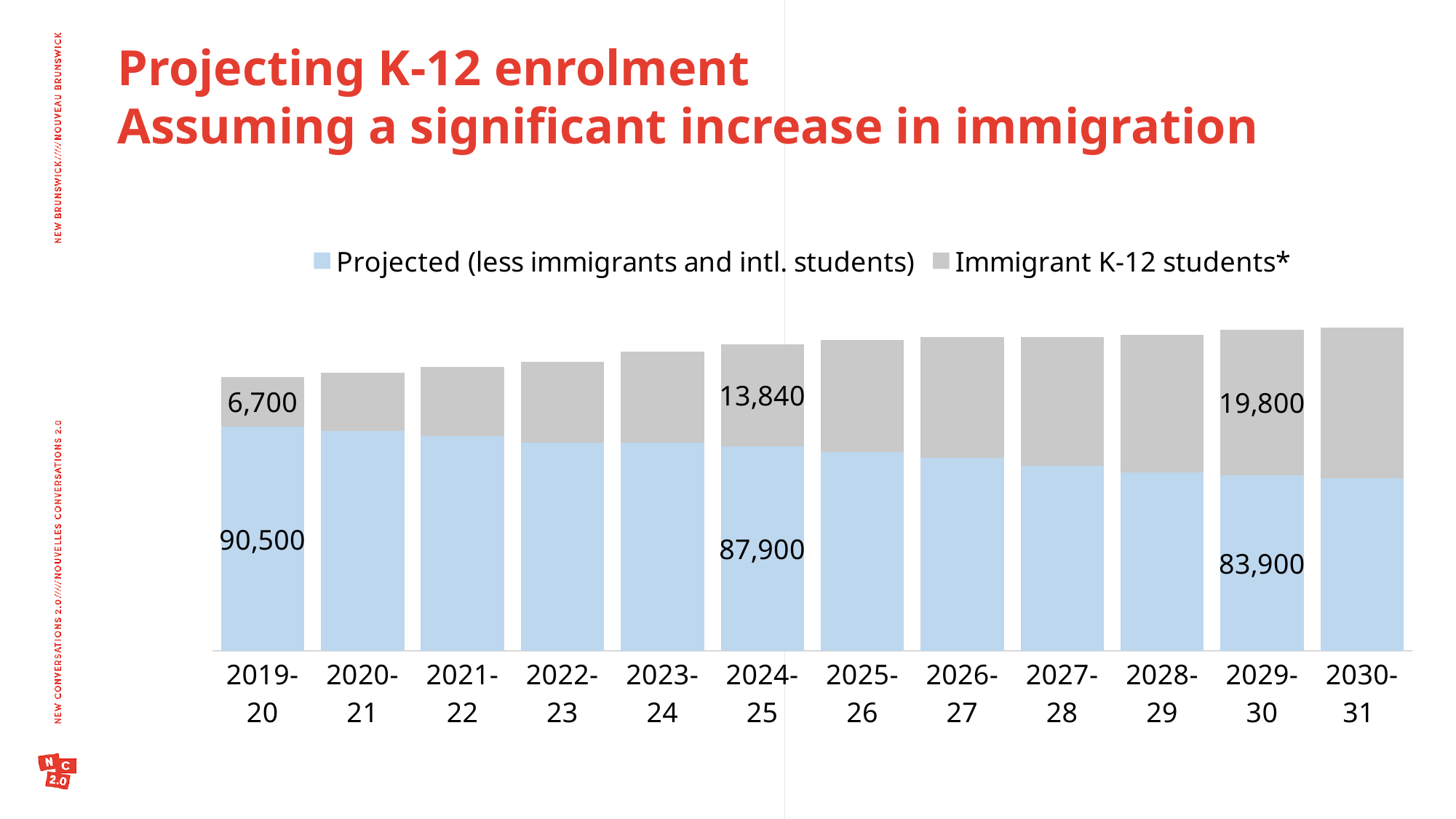
What is the value of the Immigrant K-12 students* series for 2029-30? 19,800 What is the total of the stacked bar for 2019-20? 97,200 What is the value of the Projected (less immigrants and intl. students) series for 2019-20? 90,500 Which is larger: the Immigrant K-12 students* value for 2024-25 or for 2019-20? 2024-25 What is the value of the Projected (less immigrants and intl. students) series for 2029-30? 83,900 What is the difference between the Immigrant K-12 students* values for 2029-30 and 2019-20? 13,100 What is the value of the Immigrant K-12 students* series for 2024-25? 13,840 What is the total of the stacked bar for 2029-30? 103,700 Does the Immigrant K-12 students* series rise or fall from 2019-20 to 2030-31? rise How many school years are shown on the x axis? 12 What is the difference between the Projected (less immigrants and intl. students) values for 2019-20 and 2029-30? 6,600 How many series does the legend list? 2